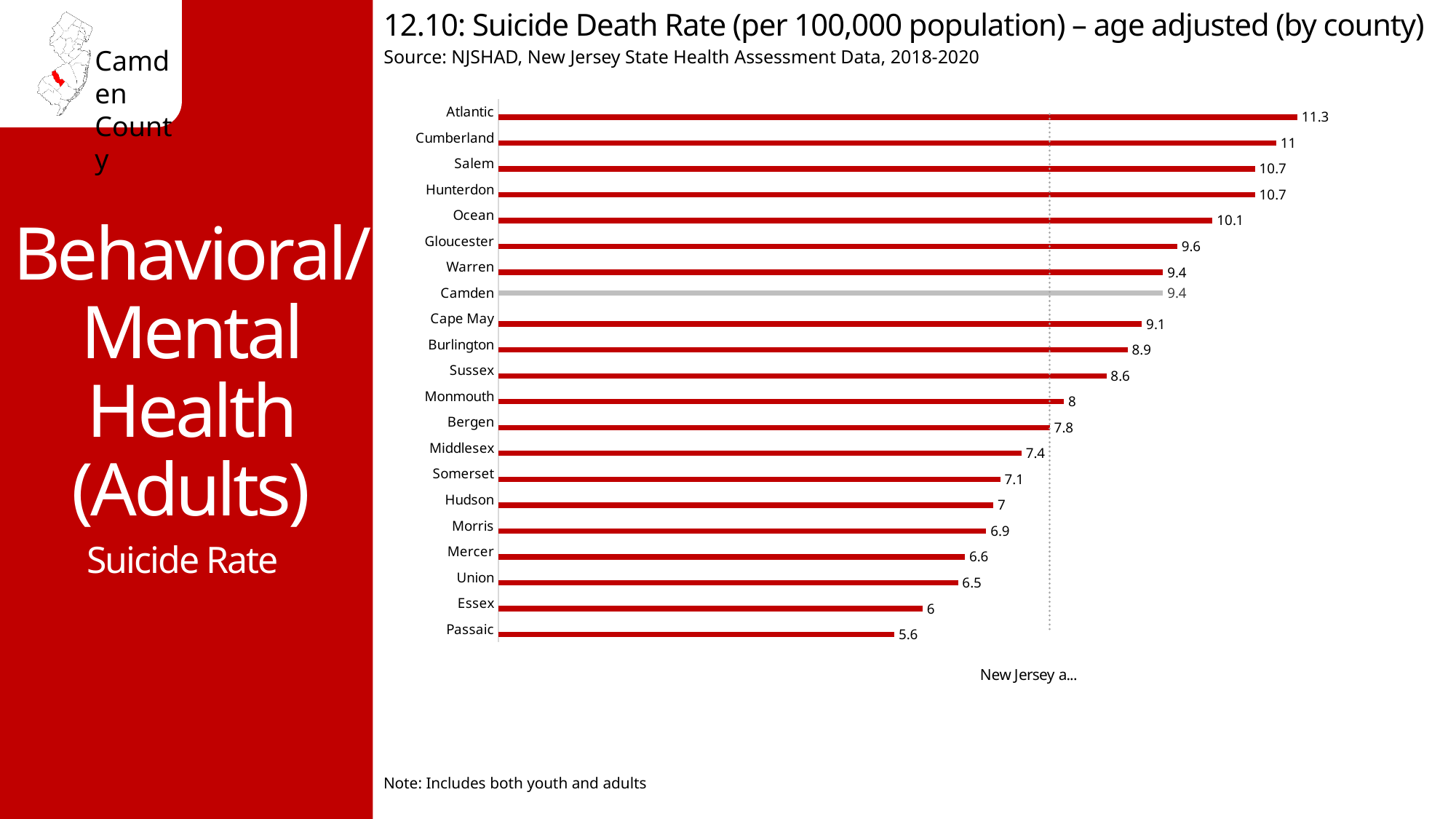
What is the suicide death rate for Camden county? 9.4 What type of chart is used on this slide? Bar chart Which county has the highest suicide death rate? Atlantic What is the difference between the suicide death rates of Atlantic and Passaic counties? 5.7 What is the suicide death rate for Atlantic county? 11.3 What is the suicide death rate for Passaic county? 5.6 Which county's bar is shown in gray rather than red? Camden Which county has the lowest suicide death rate? Passaic Which county has a higher suicide death rate, Gloucester or Burlington? Gloucester How many counties are shown in the chart? 21 What is the difference between the suicide death rates of Camden and Bergen counties? 1.6 Which county has a higher suicide death rate, Essex or Ocean? Ocean